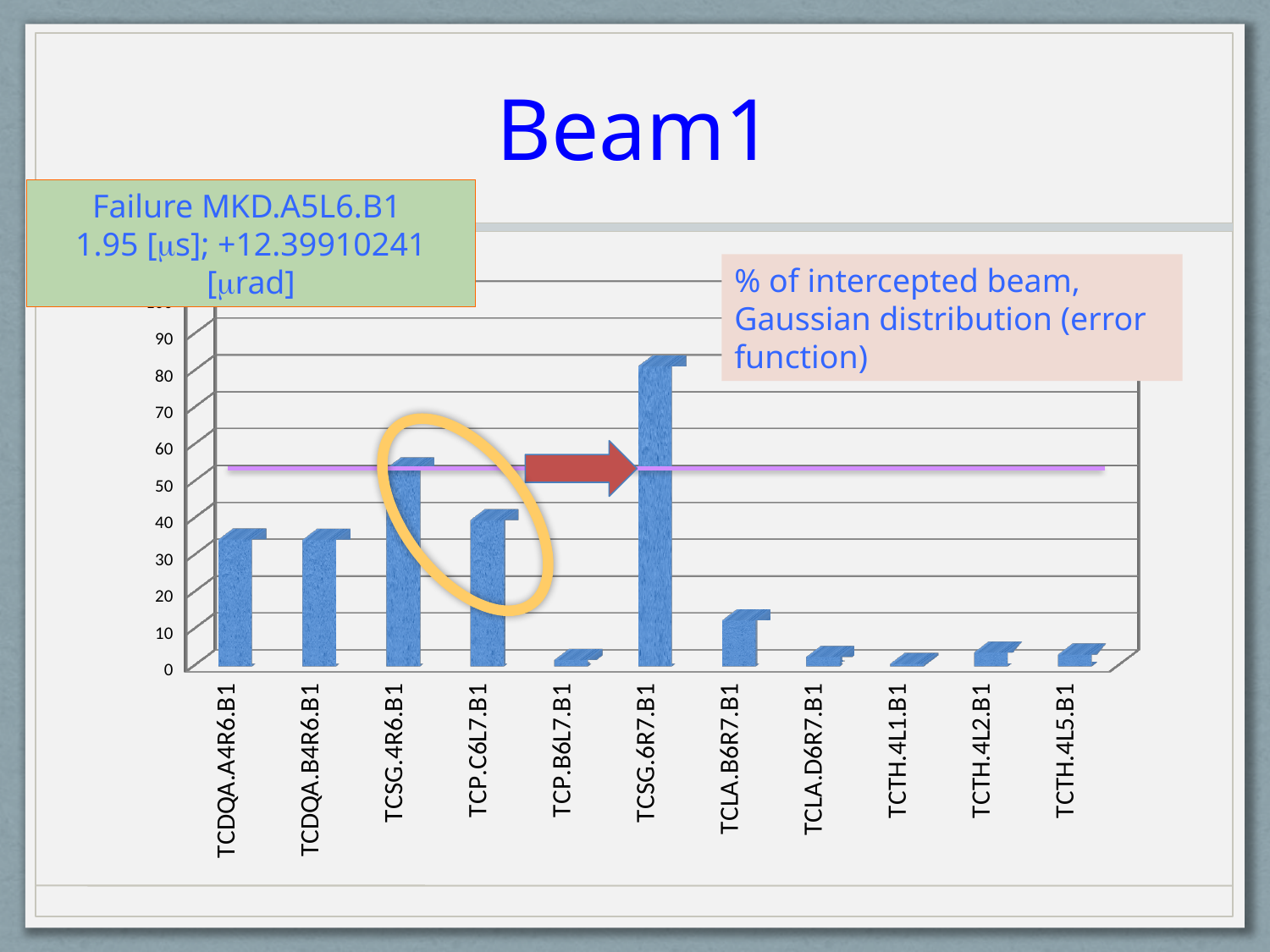
Is the value for TCDQA.A4R6.B1 greater or less than 30? greater Is the value for TCSG.4R6.B1 greater or less than 50? greater Which is larger, the value for TCSG.4R6.B1 or the value for TCP.C6L7.B1? TCSG.4R6.B1 Is the value for TCLA.B6R7.B1 greater or less than 20? less Which is larger, the value for TCLA.B6R7.B1 or the value for TCTH.4L2.B1? TCLA.B6R7.B1 How many categories are plotted along the x axis of the chart? 11 What kind of chart is shown on the slide? bar chart According to the text box on the slide, what quantity does the chart show? % of intercepted beam, Gaussian distribution (error function) Which category has the highest bar in the chart? TCSG.6R7.B1